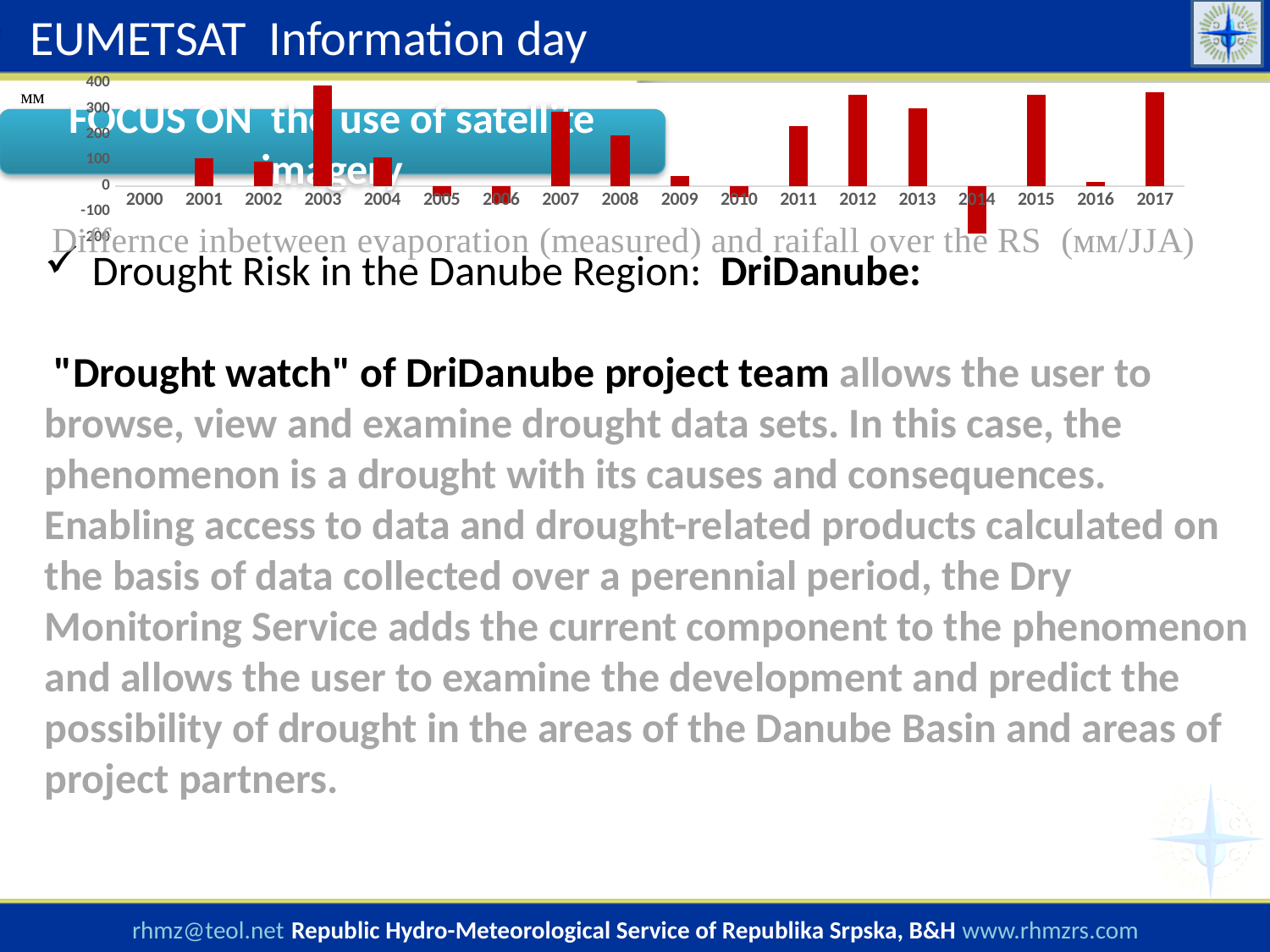
Is the value for 2007 greater or less than 200? greater What unit label is shown at the top of the y axis of the chart? MM Is the value for 2014 greater or less than -100? less Which year has the highest bar in the chart? 2003 Which is larger, the value for 2014 or the value for 2016? 2016 Which year has the lowest bar in the chart? 2014 Which is larger, the value for 2003 or the value for 2011? 2003 How many years are shown on the x axis of the chart? 18 What kind of chart is shown on the slide? bar chart Is the value for 2009 greater or less than 100? less